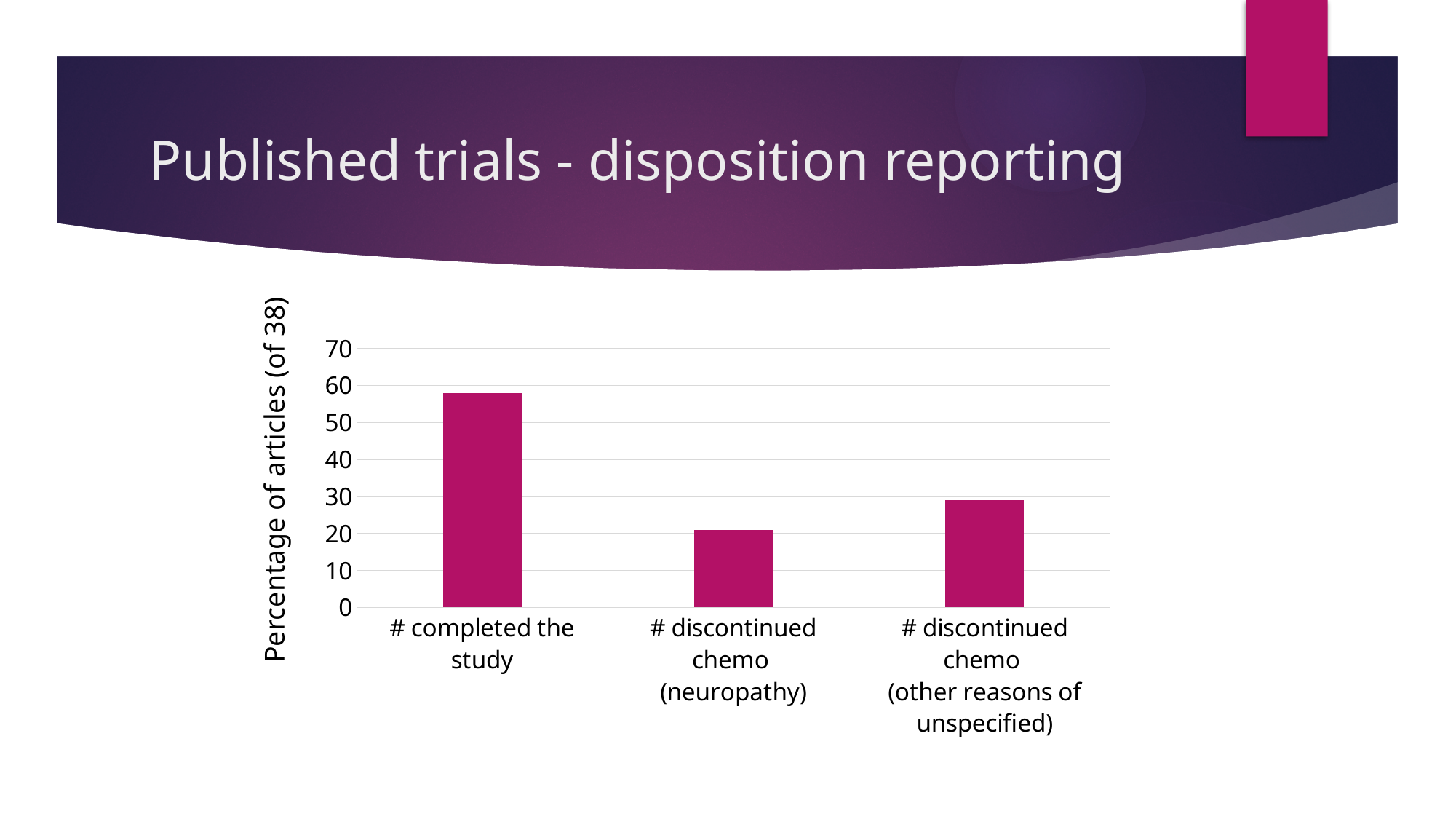
Is the value for # discontinued chemo (neuropathy) greater or less than 30? less What is the label on the y axis of the chart? Percentage of articles (of 38) Is the value for # completed the study greater or less than 50? greater Which is larger: the value for # discontinued chemo (neuropathy) or the value for # discontinued chemo (other reasons of unspecified)? # discontinued chemo (other reasons of unspecified) What is the title of the slide containing the chart? Published trials - disposition reporting Which category has the lowest bar? # discontinued chemo (neuropathy) Which category has the highest bar? # completed the study Which is larger: the value for # completed the study or the value for # discontinued chemo (other reasons of unspecified)? # completed the study Is the value for # discontinued chemo (other reasons of unspecified) greater or less than 20? greater How many categories are shown on the x axis of the chart? 3 What kind of chart is shown on the slide? bar chart